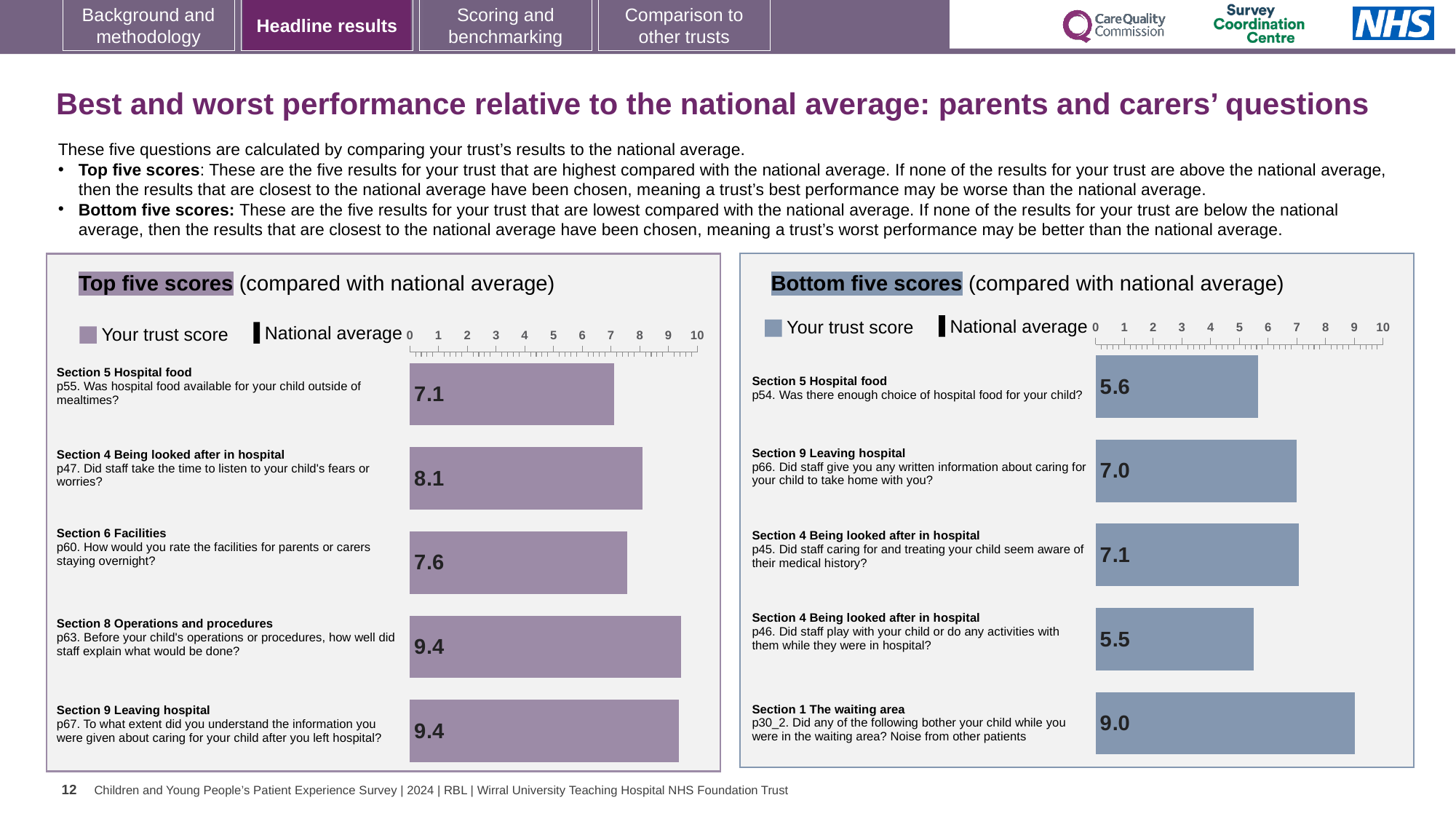
In the Top five scores chart, what is the trust score for p63 (Before your child's operations or procedures, how well did staff explain what would be done?)? 9.4 In the Bottom five scores chart, which question has the highest trust score? p30_2. Did any of the following bother your child while you were in the waiting area? Noise from other patients In the Bottom five scores chart, which has the larger trust score, p66 or p54? p66 In the Top five scores chart, is the trust score for p60 greater or less than 8? less In the Bottom five scores chart, what is the trust score for p46 (Did staff play with your child or do any activities with them while they were in hospital?)? 5.5 In the Top five scores chart, what is the trust score for p55 (Was hospital food available for your child outside of mealtimes?)? 7.1 How many questions are shown in the Bottom five scores chart? 5 In the Bottom five scores chart, what is the trust score for p30_2 (Noise from other patients in the waiting area)? 9.0 In the Top five scores chart, what is the difference between the trust scores for p47 and p55? 1.0 In the Top five scores chart, which question has the lowest trust score? p55. Was hospital food available for your child outside of mealtimes? In the Bottom five scores chart, what is the difference between the trust scores for p30_2 and p46? 3.5 What kind of chart is the Top five scores chart? bar chart